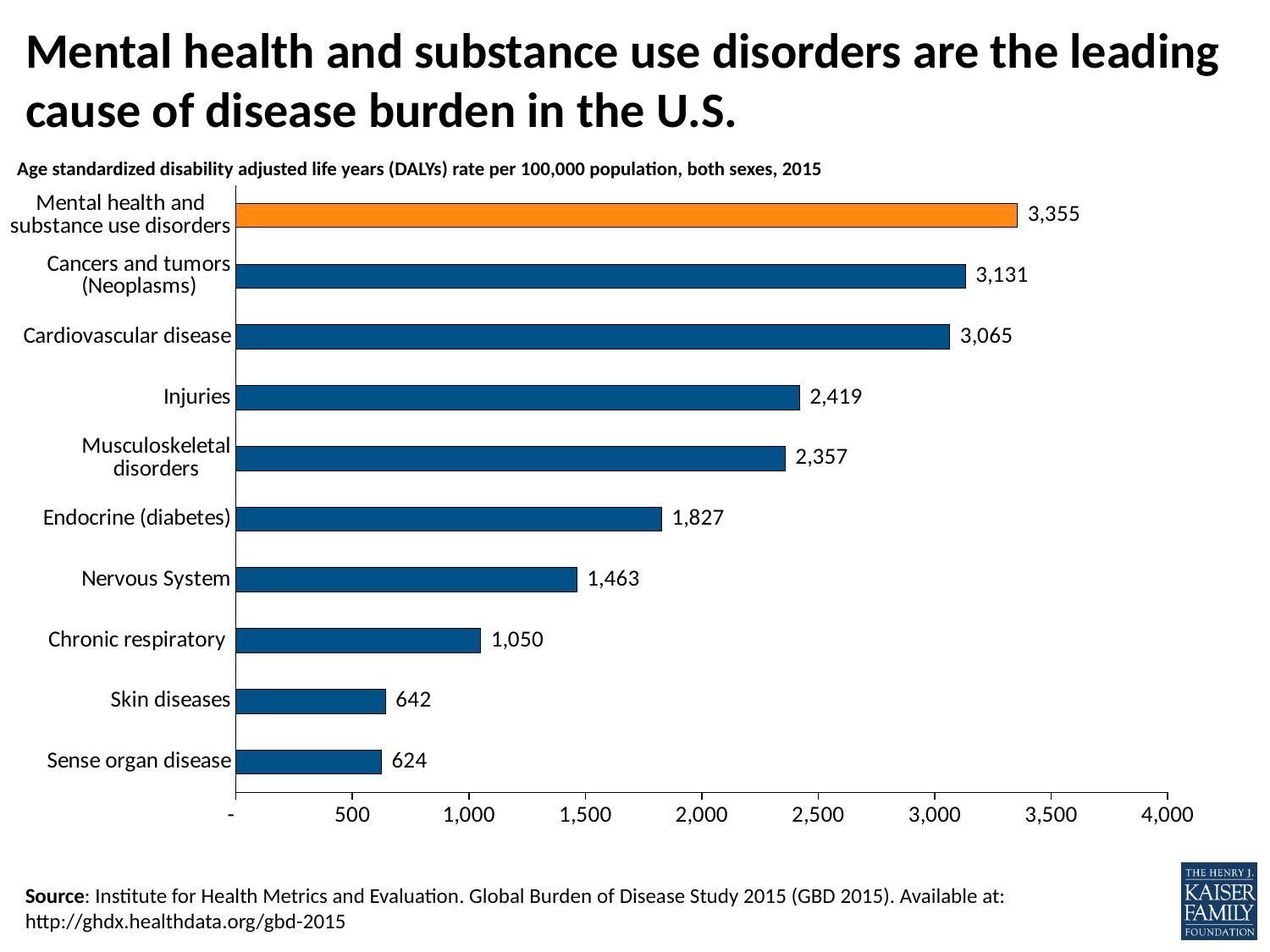
What is the value shown for Injuries? 2,419 Which is larger, the value for Musculoskeletal disorders or the value for Nervous System? Musculoskeletal disorders What is the difference between the values for Mental health and substance use disorders and Endocrine (diabetes)? 1,528 Which category has the highest DALYs rate? Mental health and substance use disorders What kind of chart is shown on the slide? Bar chart How many categories are shown in the chart? 10 Which bar is highlighted in orange rather than blue? Mental health and substance use disorders What is the value shown for Chronic respiratory? 1,050 Is the value for Endocrine (diabetes) greater or less than 2,000? less Which category has the lowest DALYs rate? Sense organ disease What is the DALYs rate per 100,000 for Mental health and substance use disorders? 3,355 What is the difference between the values for Cancers and tumors (Neoplasms) and Cardiovascular disease? 66